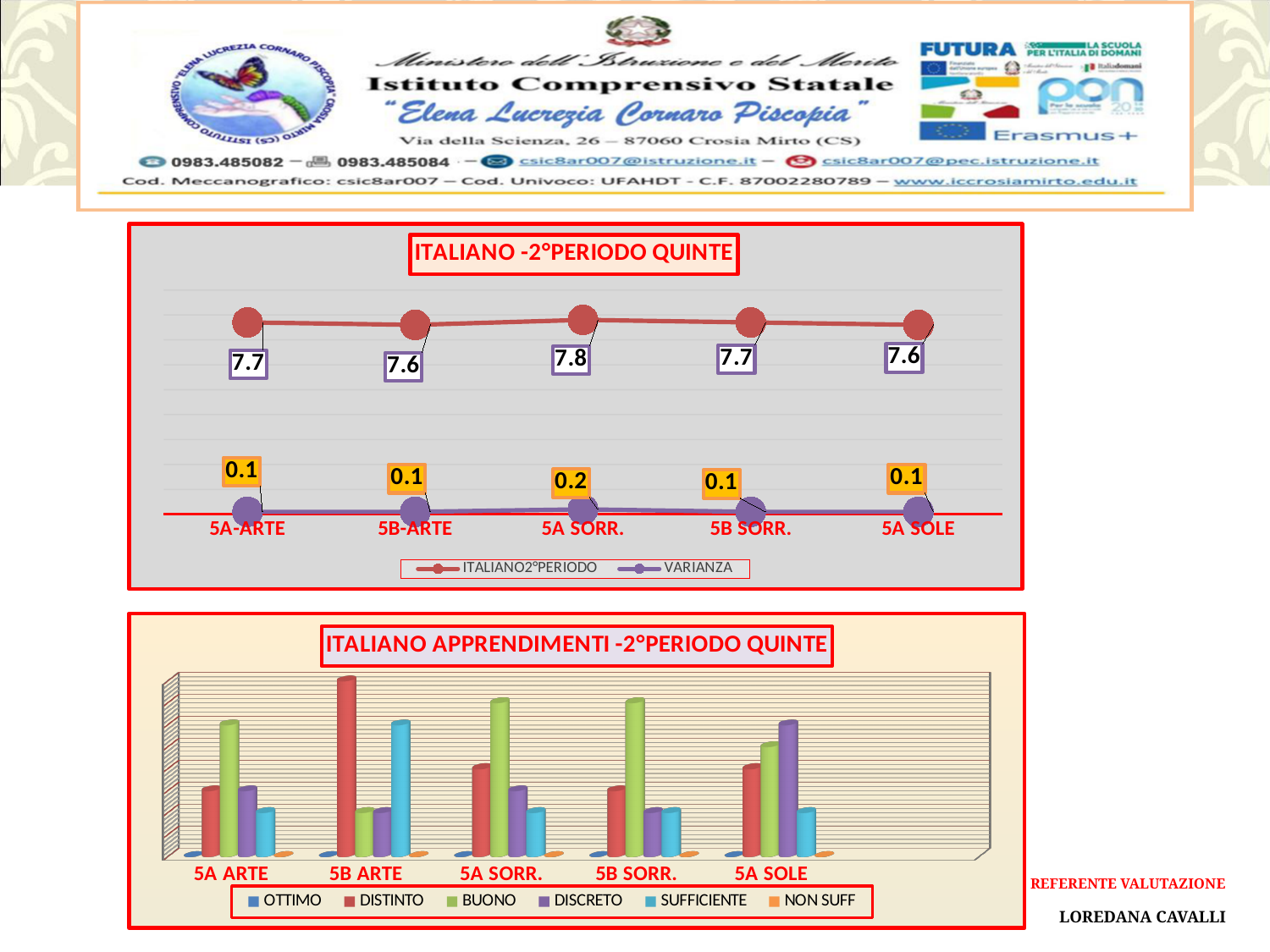
What kind of chart is the one titled 'ITALIANO -2°PERIODO QUINTE'? Line chart In the chart titled 'ITALIANO -2°PERIODO QUINTE', which class has the highest ITALIANO2°PERIODO value? 5A SORR. In the chart titled 'ITALIANO APPRENDIMENTI -2°PERIODO QUINTE', how many series does the legend list? 6 In the chart titled 'ITALIANO -2°PERIODO QUINTE', which class has the highest VARIANZA value? 5A SORR. In the chart titled 'ITALIANO -2°PERIODO QUINTE', what is the VARIANZA value for 5A SORR.? 0.2 In the chart titled 'ITALIANO -2°PERIODO QUINTE', what is the ITALIANO2°PERIODO value for 5B-ARTE? 7.6 In the chart titled 'ITALIANO -2°PERIODO QUINTE', what is the ITALIANO2°PERIODO value for 5A SORR.? 7.8 In the chart titled 'ITALIANO APPRENDIMENTI -2°PERIODO QUINTE', which series has the tallest bar for 5B ARTE? DISTINTO In the chart titled 'ITALIANO -2°PERIODO QUINTE', how many series does the legend list? 2 In the chart titled 'ITALIANO -2°PERIODO QUINTE', which is larger: the ITALIANO2°PERIODO value for 5A-ARTE or for 5A SOLE? 5A-ARTE What kind of chart is the one titled 'ITALIANO APPRENDIMENTI -2°PERIODO QUINTE'? Bar chart In the chart titled 'ITALIANO -2°PERIODO QUINTE', what is the difference between the ITALIANO2°PERIODO values for 5A SORR. and 5B-ARTE? 0.2